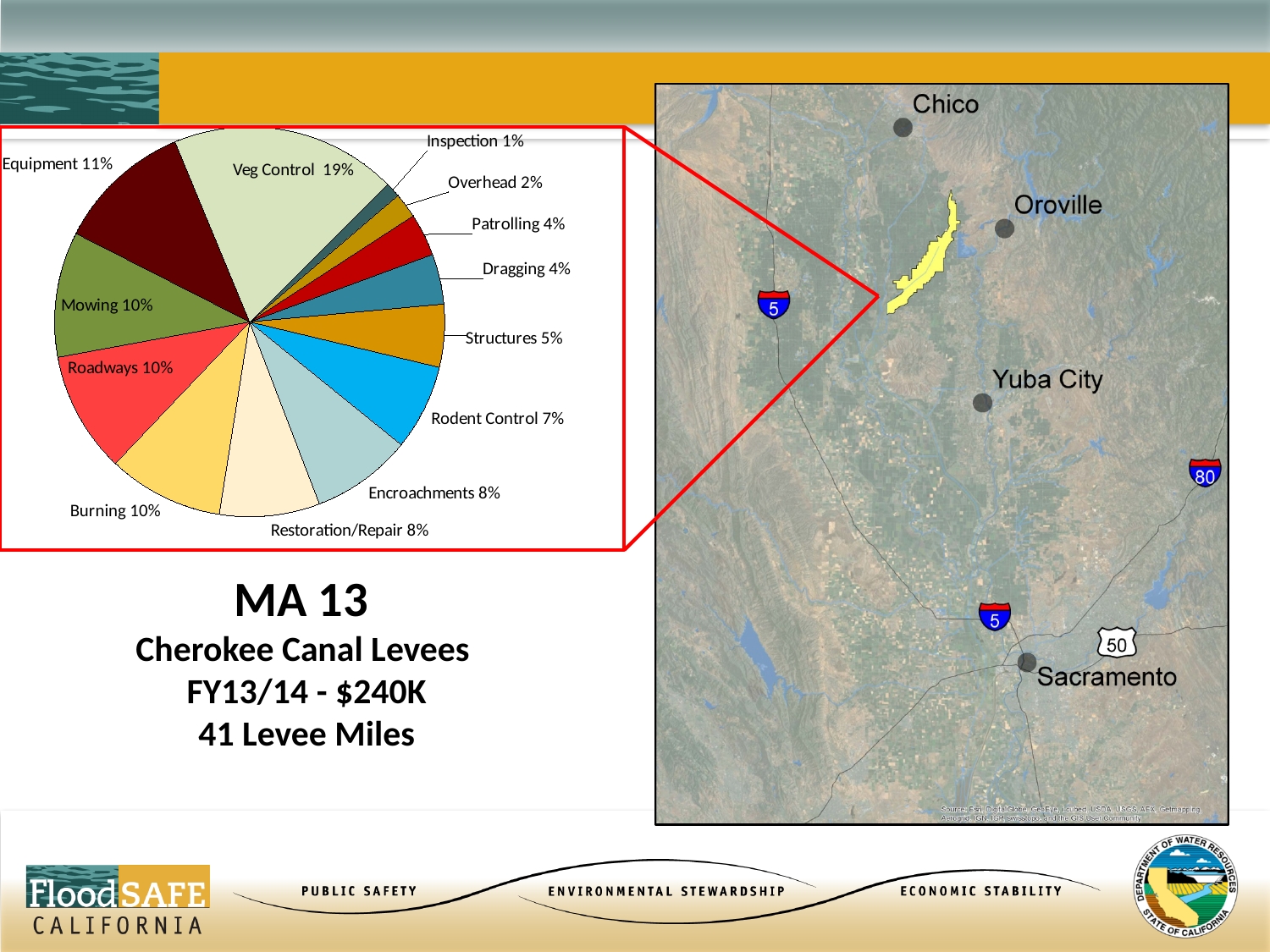
What percentage is shown for Restoration/Repair? 8% Which category has the smallest slice of the pie chart? Inspection What share of the pie does Rodent Control represent? 7% What is the FY13/14 budget amount shown below the pie chart? $240K Which is larger, the Structures slice or the Overhead slice? Structures What percentage of the pie chart is Veg Control? 19% How many categories are shown in the pie chart? 13 What percentage is shown for Equipment? 11% What is the difference in percentage points between Veg Control and Equipment? 8 What type of chart is shown on the slide? pie chart Which category has the largest slice of the pie chart? Veg Control What is the combined percentage of Mowing, Roadways and Burning? 30%